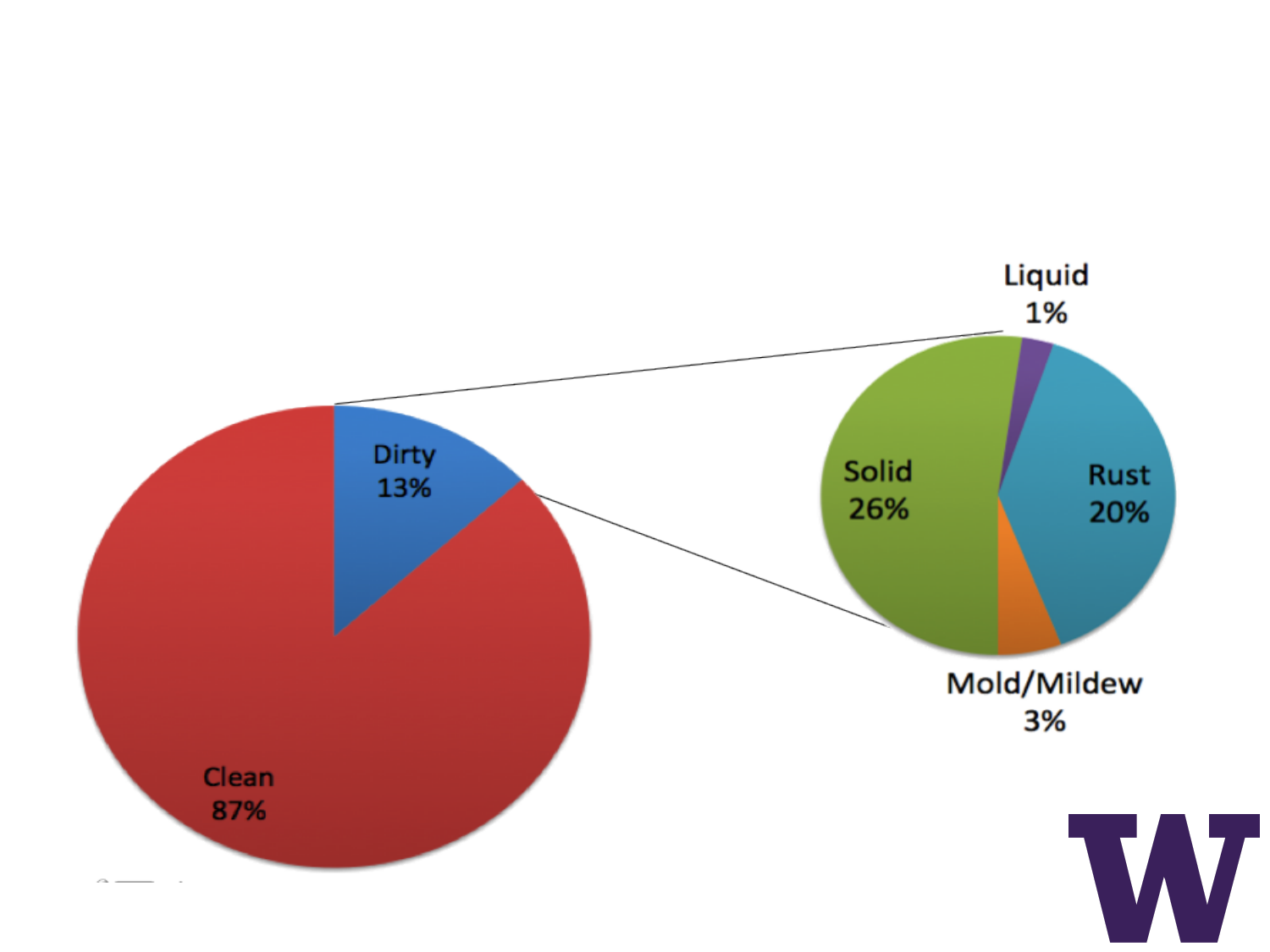
In the right pie chart, what is the difference in percentage points between Solid and Rust? 6 In the right pie chart, which category has the smallest slice? Liquid In the right pie chart, what percentage is labelled for Mold/Mildew? 3% In the left pie chart, what percentage is labelled for Clean? 87% In the right pie chart, what percentage is labelled for Rust? 20% In the left pie chart, which is larger, Clean or Dirty? Clean What kind of chart is the left chart on the slide? Pie chart In the right pie chart, which category has the largest slice? Solid In the right pie chart, what percentage is labelled for Solid? 26% In the right pie chart, what percentage is labelled for Liquid? 1% In the left pie chart, what percentage is labelled for Dirty? 13% How many slices does the right pie chart have? 4